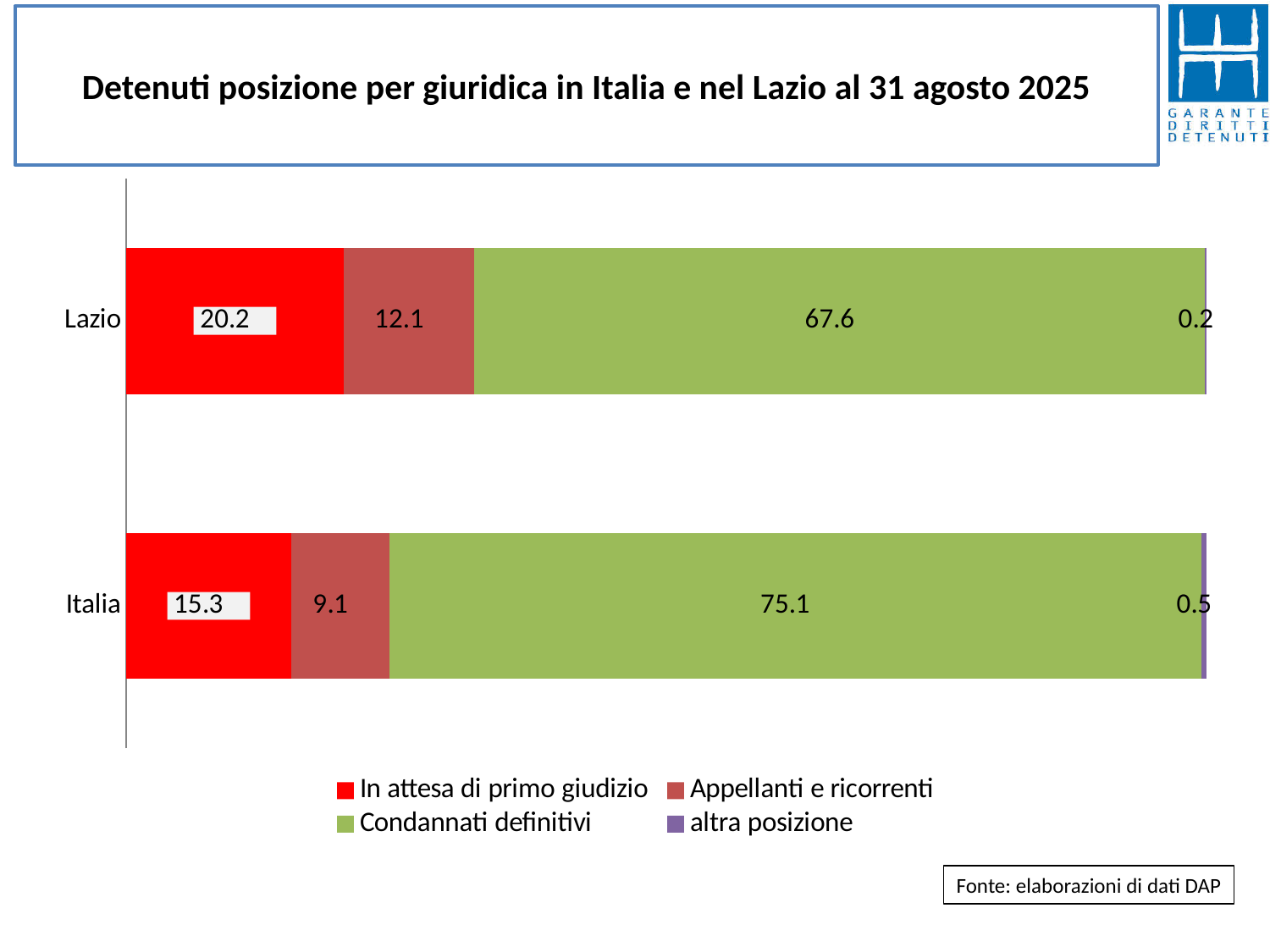
Which series has the smallest value for Italia? altra posizione Which series has the largest value for Lazio? Condannati definitivi What is the title of the chart? Detenuti posizione per giuridica in Italia e nel Lazio al 31 agosto 2025 What is the value for 'In attesa di primo giudizio' for Lazio? 20.2 Which has the larger 'In attesa di primo giudizio' value, Lazio or Italia? Lazio What is the value for 'altra posizione' for Italia? 0.5 What is the difference between the 'Condannati definitivi' values for Italia and Lazio? 7.5 How many series does the legend list? 4 What is the value for 'Condannati definitivi' for Italia? 75.1 What kind of chart is shown on the slide? Stacked bar chart How many categories are plotted on the chart? 2 What is the value for 'Appellanti e ricorrenti' for Lazio? 12.1